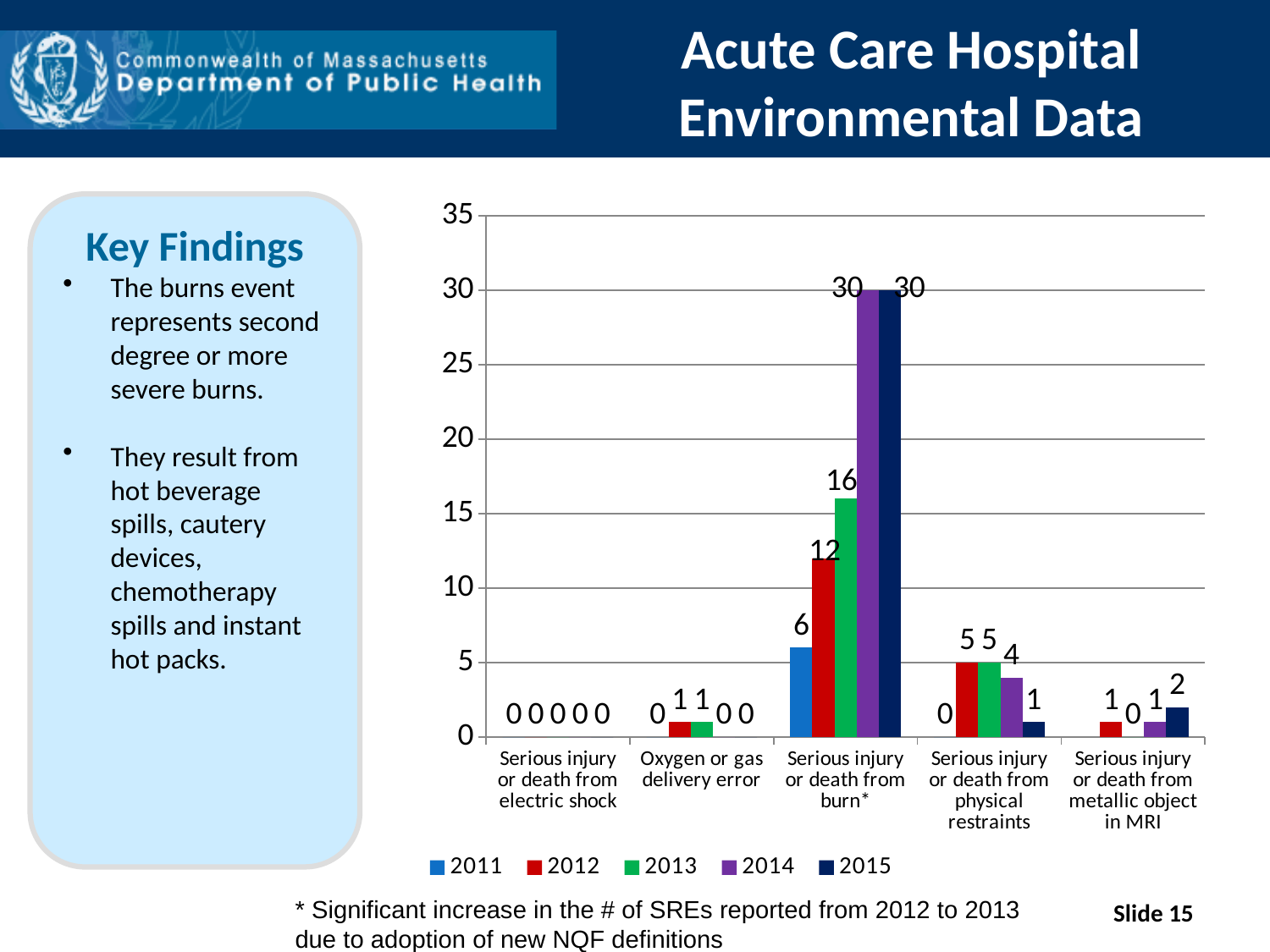
What is the 2013 value for Serious injury or death from burn? 16 How many series does the legend list? 5 Which is larger for Serious injury or death from burn: the 2012 value or the 2013 value? 2013 What is the 2015 value for Serious injury or death from metallic object in MRI? 2 Which year is shown in the legend with a green colour? 2013 What is the 2012 value for Serious injury or death from physical restraints? 5 What is the difference between the 2014 and 2011 values for Serious injury or death from burn? 24 What type of chart is shown on the slide? bar chart What is the 2012 value for Oxygen or gas delivery error? 1 How many categories are shown on the x axis? 5 Do the values for Serious injury or death from burn rise or fall from 2011 to 2014? rise Which category has the highest value in 2014? Serious injury or death from burn